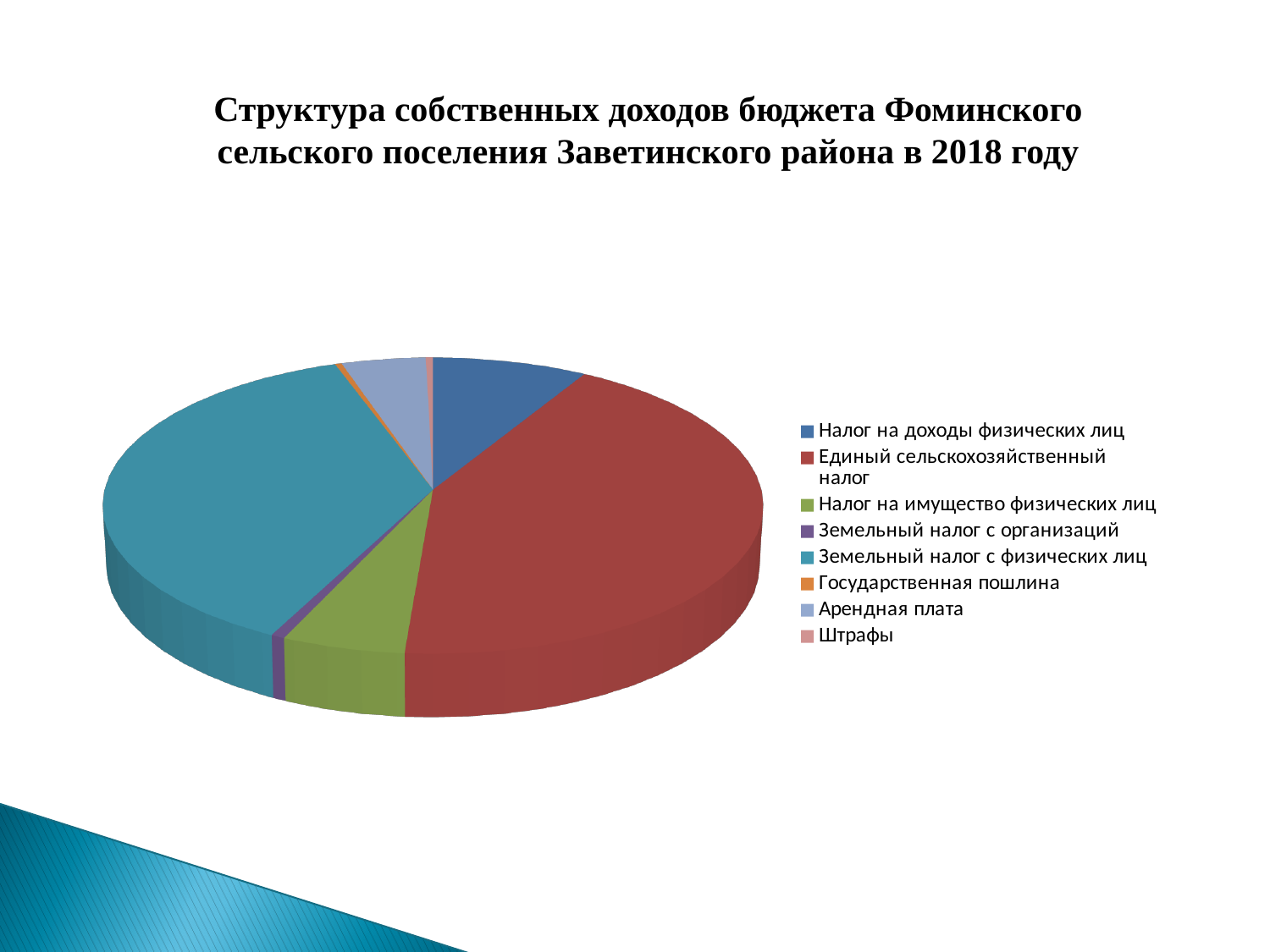
Which year does the chart title say the budget income structure refers to? 2018 What kind of chart is shown on the slide? pie chart Which slice is larger: Земельный налог с физических лиц or Арендная плата? Земельный налог с физических лиц Which slice is larger: Земельный налог с физических лиц or Налог на имущество физических лиц? Земельный налог с физических лиц Which category has the largest slice of the pie? Единый сельскохозяйственный налог Which slice is larger: Налог на имущество физических лиц or Земельный налог с организаций? Налог на имущество физических лиц Which category is shown in red in the pie chart? Единый сельскохозяйственный налог How many categories does the pie chart's legend list? 8